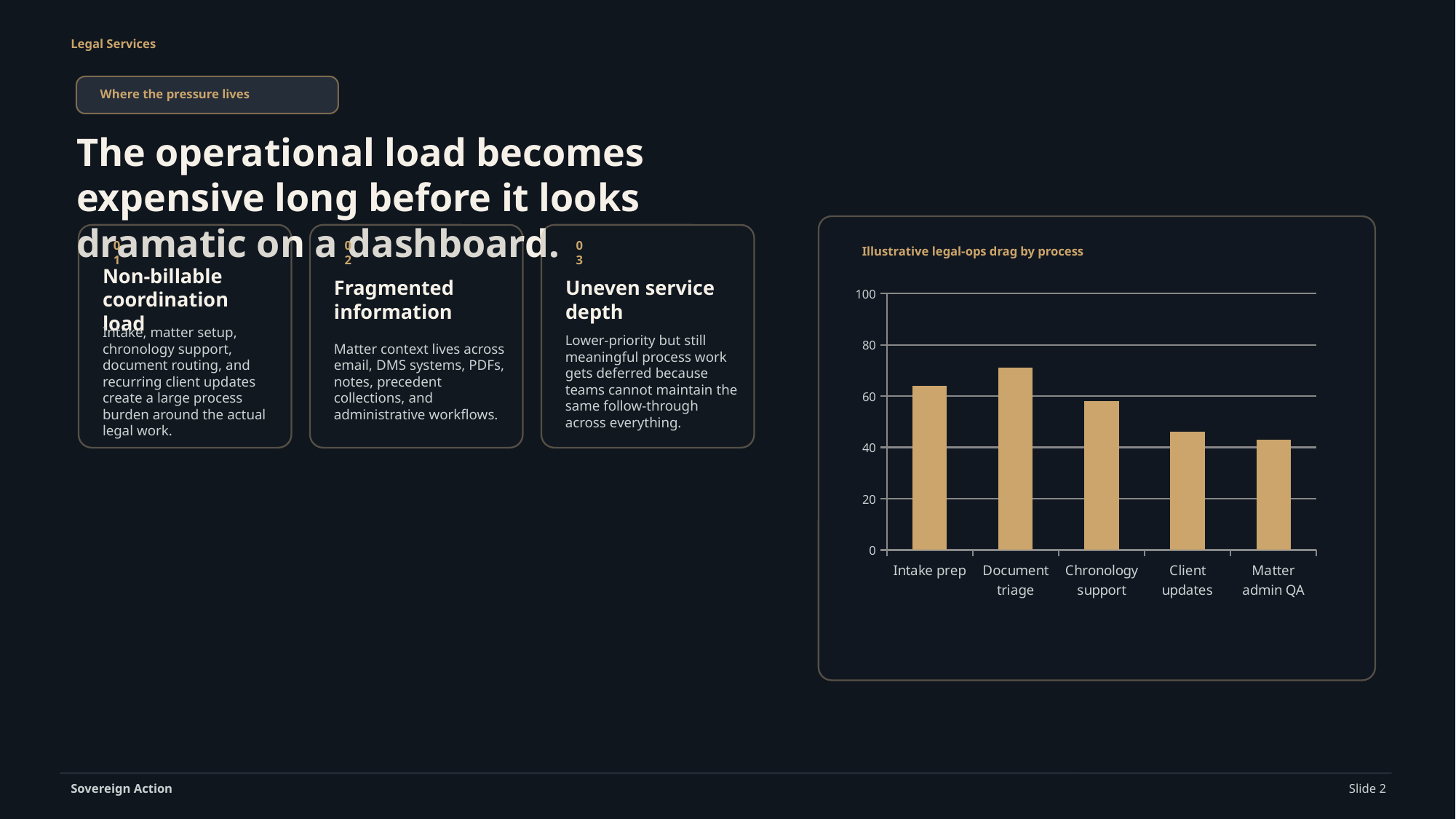
Is the value for Client updates greater or less than 60? less Is the value for Document triage greater or less than 80? less Which is larger, the value for Document triage or the value for Client updates? Document triage Is the value for Matter admin QA greater or less than 60? less What is the title of the chart? Illustrative legal-ops drag by process What kind of chart is shown on the slide? Bar chart From Document triage to Matter admin QA, do the values rise or fall along the x axis? Fall Which process has the highest value on the chart? Document triage Which is larger, the value for Intake prep or the value for Chronology support? Intake prep How many process categories are plotted on the chart? 5